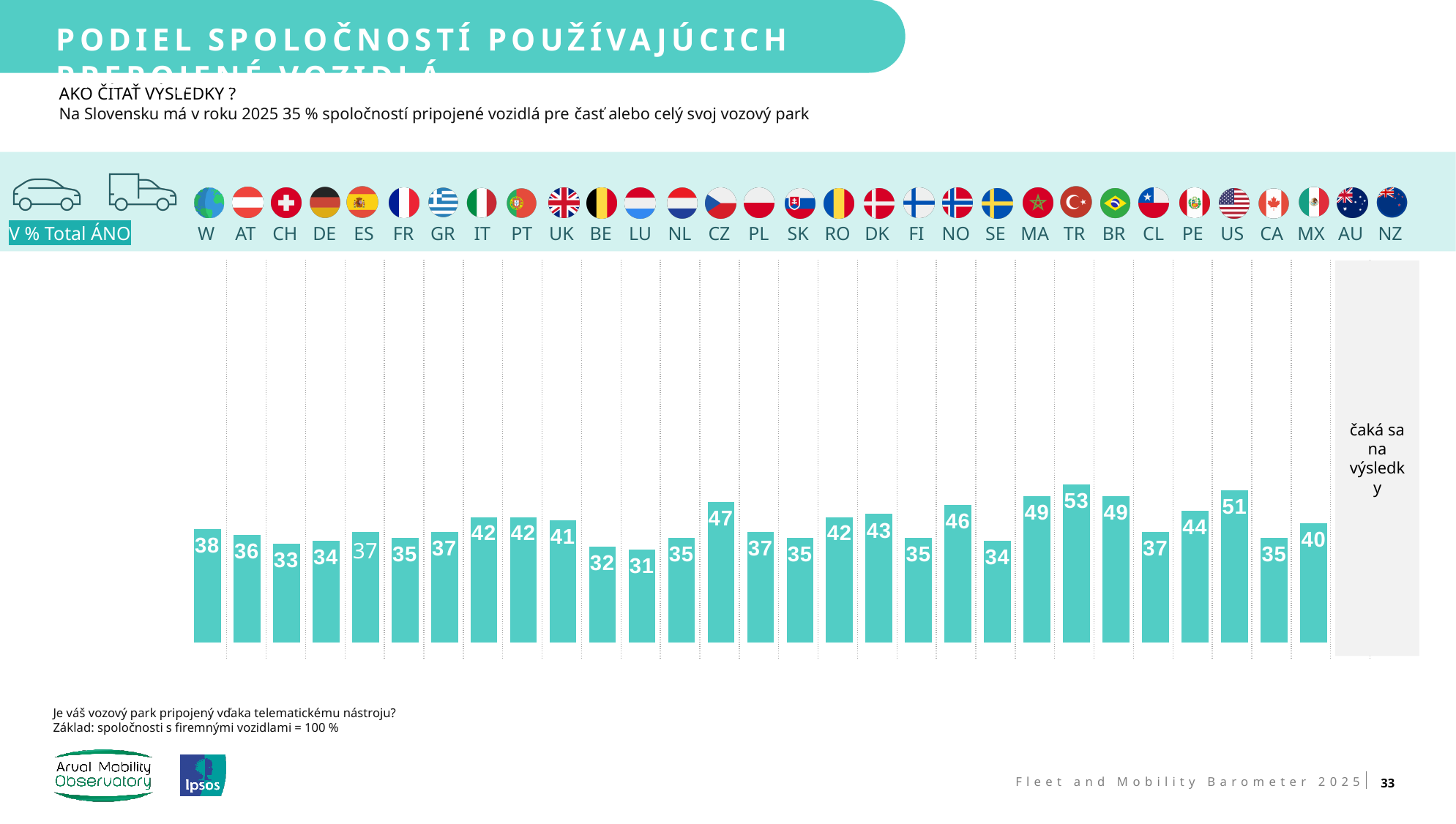
How many countries/regions have a plotted bar with a value? 29 Which country has the lowest value? LU What is the value for TR? 53 What is the difference between the values for US and CA? 16 What is the value for SK? 35 Which country has the highest value? TR Which has a larger value, NO or DK? NO What is the value for W (the total)? 38 Which has a larger value, BE or MX? MX What kind of chart is shown on the slide? Bar chart What is the value for CZ? 47 What is shown in place of bars for AU and NZ? čaká sa na výsledky